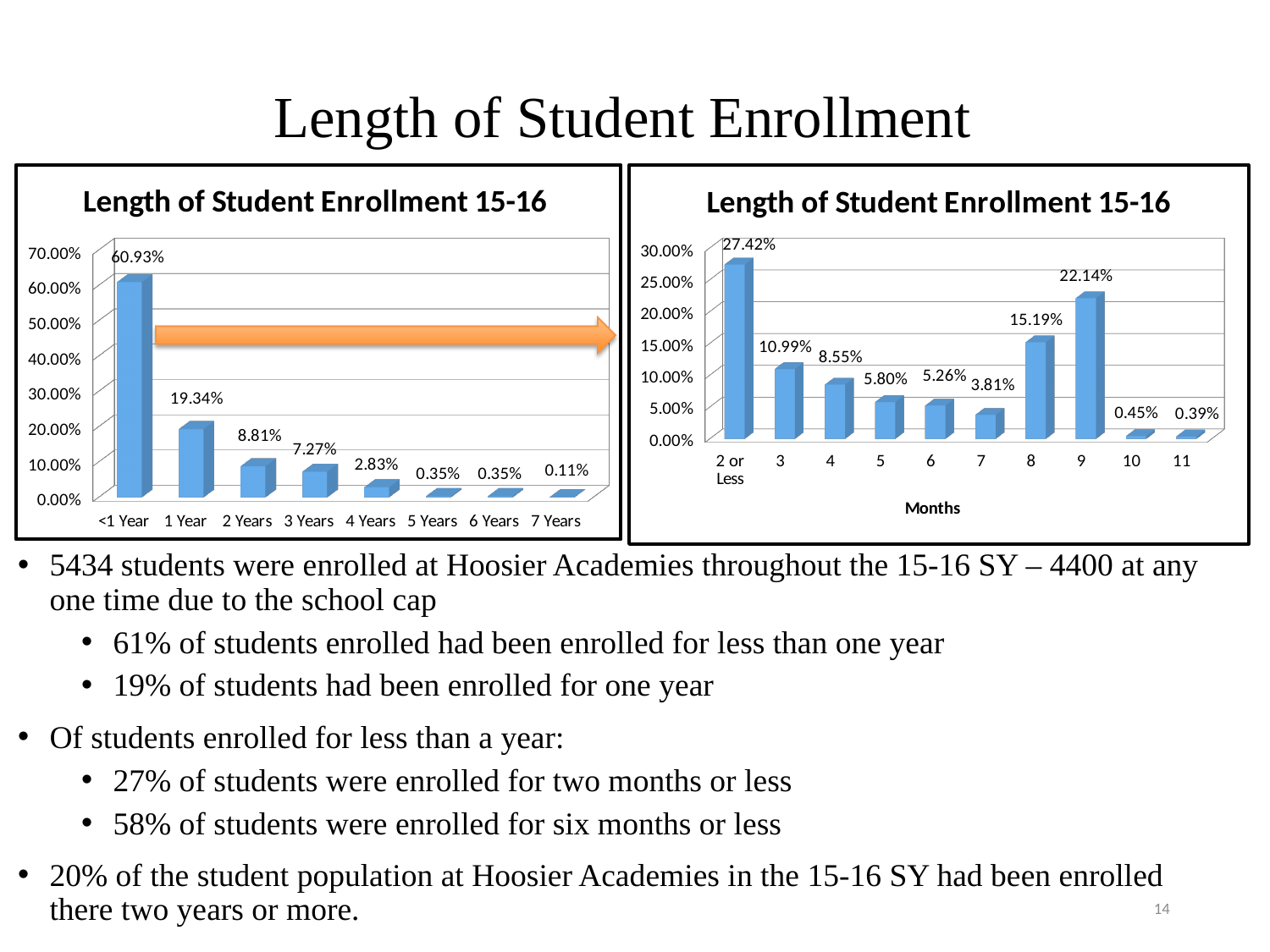
What is the x-axis title of the right chart? Months In the left chart, what is the value for 1 Year? 19.34% In the right chart, which month category has the highest value? 2 or Less What type of chart is the right chart? Bar chart In the left chart, which category has the highest value? <1 Year In the right chart, what is the difference between the values for 2 or Less and 9 months? 5.28% How many categories are shown on the x axis of the right chart? 10 In the left chart, what is the difference between the values for 2 Years and 3 Years? 1.54% In the left chart, which category has the lowest value? 7 Years How many categories are shown on the x axis of the left chart? 8 In the right chart, which is larger, the value for 8 months or the value for 3 months? 8 months In the right chart, what is the value for 9 months? 22.14%